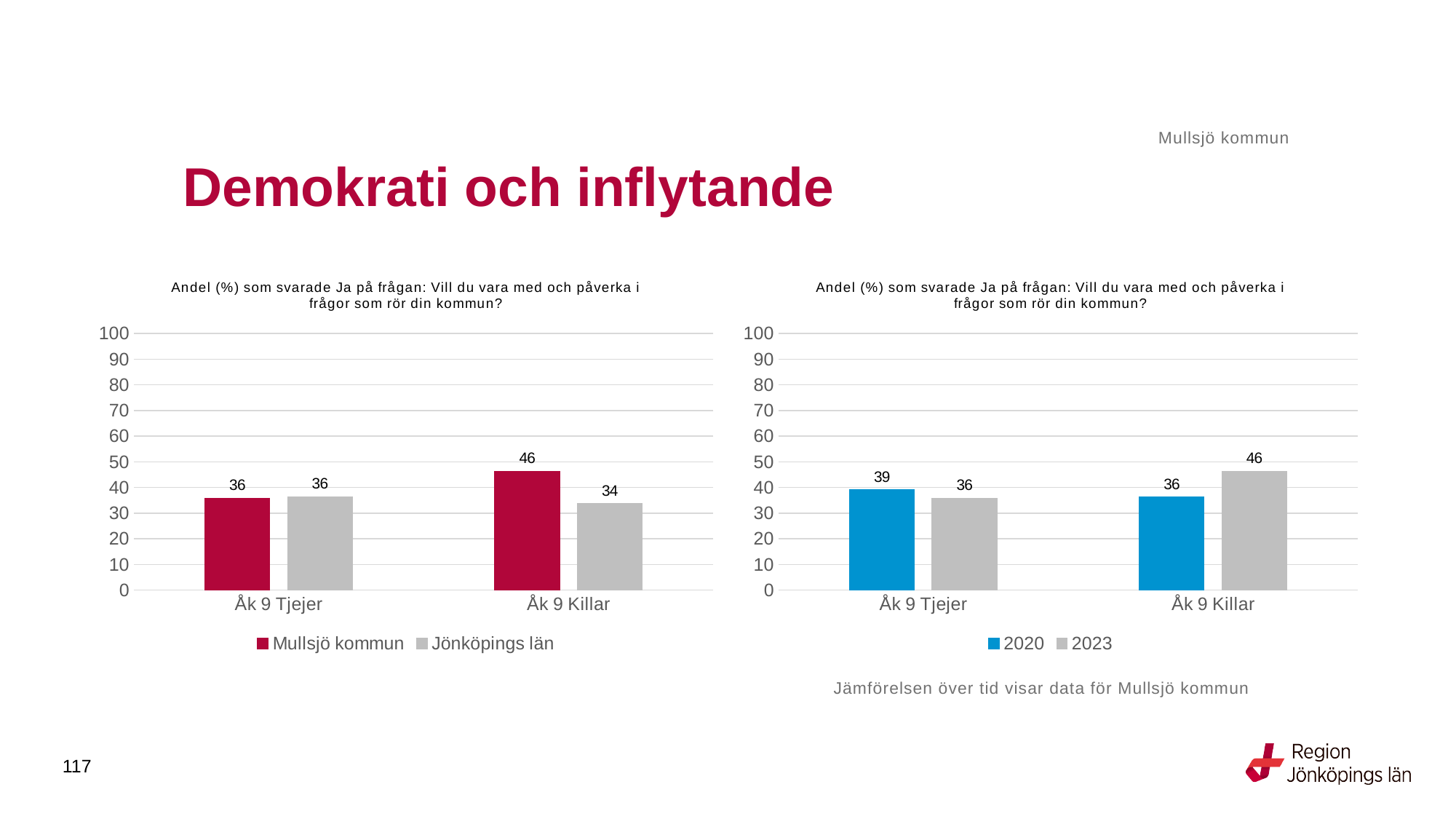
In the left chart, what is the value for Mullsjö kommun for Åk 9 Killar? 46 In the right chart, what is the difference between 2023 and 2020 for Åk 9 Killar? 10 In the right chart, what is the value for 2023 for Åk 9 Killar? 46 What are the legend entries of the left chart? Mullsjö kommun, Jönköpings län In the left chart, what is the difference between Mullsjö kommun and Jönköpings län for Åk 9 Killar? 12 In the left chart, what is the value for Jönköpings län for Åk 9 Tjejer? 36 In the right chart, which category has the lowest value for 2023? Åk 9 Tjejer How many series does the legend of the right chart list? 2 In the left chart, which category has the highest value for Mullsjö kommun? Åk 9 Killar In the right chart, which is larger for Åk 9 Tjejer, 2020 or 2023? 2020 In the right chart, what is the value for 2020 for Åk 9 Tjejer? 39 What kind of chart is the left chart? Bar chart